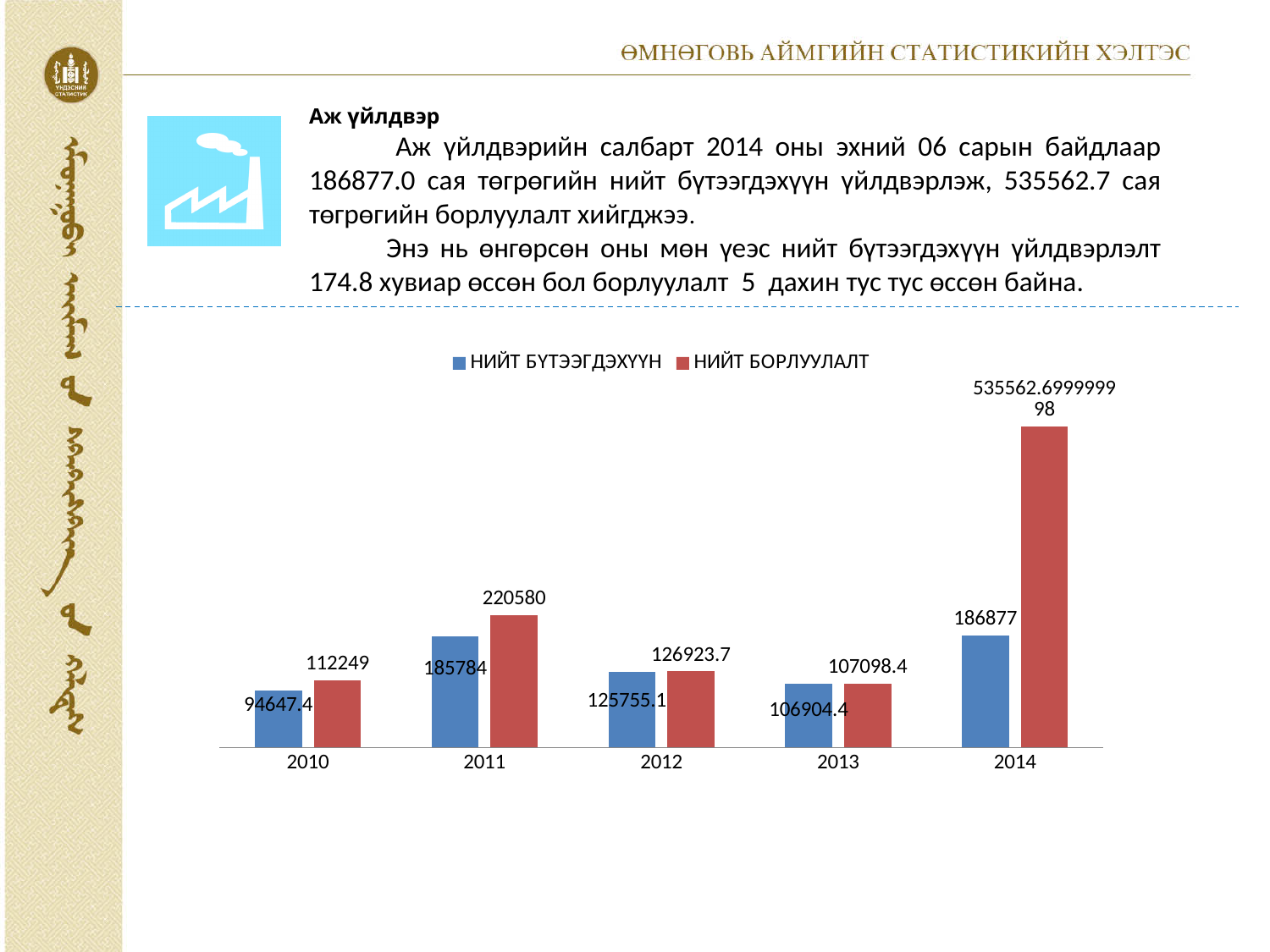
What is the value of НИЙТ БҮТЭЭГДЭХҮҮН for 2014? 186877 How many series does the chart legend list? 2 What is the value of НИЙТ БОРЛУУЛАЛТ for 2013? 107098.4 What is the value of НИЙТ БОРЛУУЛАЛТ for 2011? 220580 Which year has the highest value for НИЙТ БОРЛУУЛАЛТ? 2014 What kind of chart is shown on the slide? Bar chart What is the difference between НИЙТ БОРЛУУЛАЛТ and НИЙТ БҮТЭЭГДЭХҮҮН in 2011? 34796 In 2014, which is larger: НИЙТ БҮТЭЭГДЭХҮҮН or НИЙТ БОРЛУУЛАЛТ? НИЙТ БОРЛУУЛАЛТ What is the value of НИЙТ БҮТЭЭГДЭХҮҮН for 2010? 94647.4 Does the value of НИЙТ БОРЛУУЛАЛТ rise or fall from 2011 to 2013? Fall How many years are shown on the x axis of the chart? 5 Which year has the lowest value for НИЙТ БҮТЭЭГДЭХҮҮН? 2010